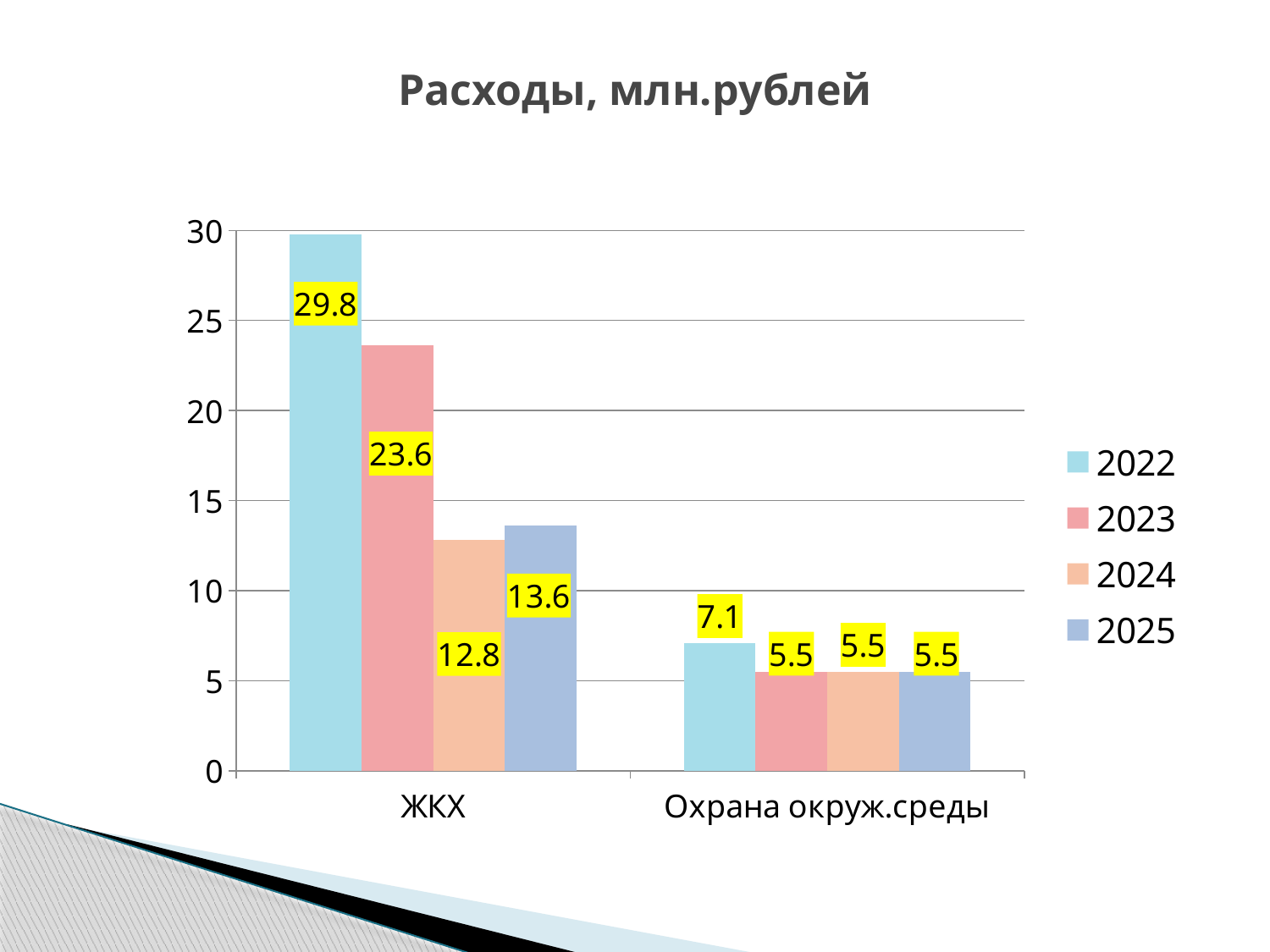
What is the value for ЖКХ in 2022? 29.8 What is the title of the chart? Расходы, млн.рублей What is the difference between the 2022 values for ЖКХ and Охрана окруж.среды? 22.7 How many series does the legend list? 4 What is the value for ЖКХ in 2025? 13.6 Which year has the highest value for ЖКХ? 2022 Which is larger: the 2025 value for ЖКХ or the 2025 value for Охрана окруж.среды? ЖКХ What kind of chart is shown on the slide? bar chart What is the value for Охрана окруж.среды in 2024? 5.5 What is the difference between the ЖКХ values for 2022 and 2023? 6.2 How many categories are shown on the x axis? 2 Which year has the lowest value for ЖКХ? 2024